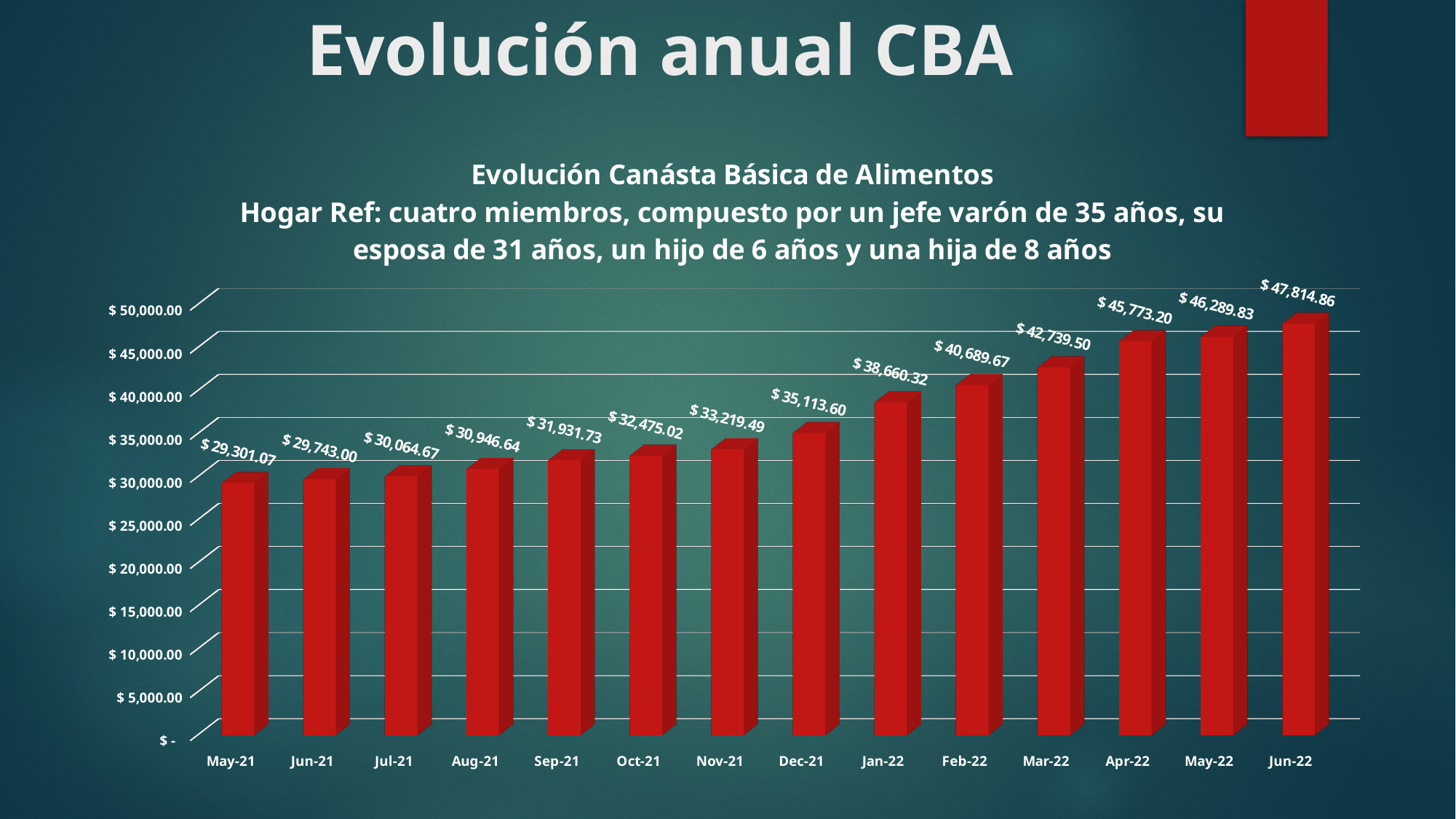
Which month has the lowest value? May-21 Which is larger, the value for Mar-22 or the value for Jan-22? Mar-22 What is the value for Dec-21? $ 35,113.60 How many months are shown on the x axis? 14 What is the difference between the values for Dec-21 and Nov-21? $ 1,894.11 What is the difference between the values for Jun-22 and May-21? $ 18,513.79 Do the values rise or fall from May-21 to Jun-22? rise What kind of chart is this? bar chart Which month has the highest value? Jun-22 Is the value for Feb-22 greater or less than $ 40,000.00? greater What is the value for Jun-22? $ 47,814.86 What is the value for Sep-21? $ 31,931.73